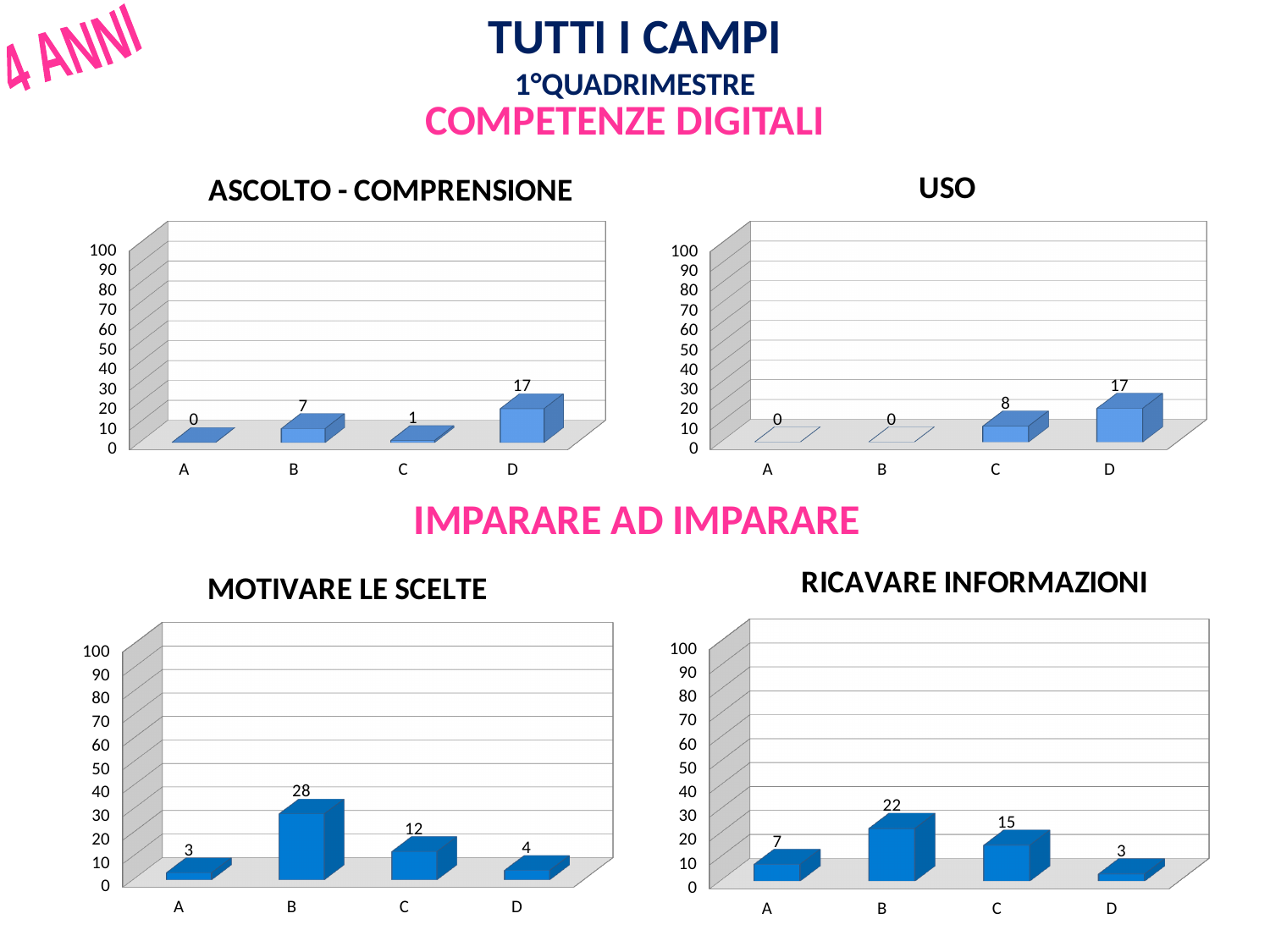
In the ASCOLTO - COMPRENSIONE chart, which category has the highest value? D In the RICAVARE INFORMAZIONI chart, what is the value for C? 15 In the RICAVARE INFORMAZIONI chart, is the value for B greater or less than 20? greater In the RICAVARE INFORMAZIONI chart, which is larger, the value for A or the value for D? A In the MOTIVARE LE SCELTE chart, what is the value for B? 28 In the MOTIVARE LE SCELTE chart, what is the difference between the values for B and C? 16 What kind of chart is the MOTIVARE LE SCELTE chart? Bar chart In the USO chart, what is the difference between the values for D and C? 9 In the MOTIVARE LE SCELTE chart, which category has the lowest value? A In the USO chart, how many categories have a value of 0? 2 In the USO chart, what is the value for C? 8 In the ASCOLTO - COMPRENSIONE chart, what is the value for D? 17